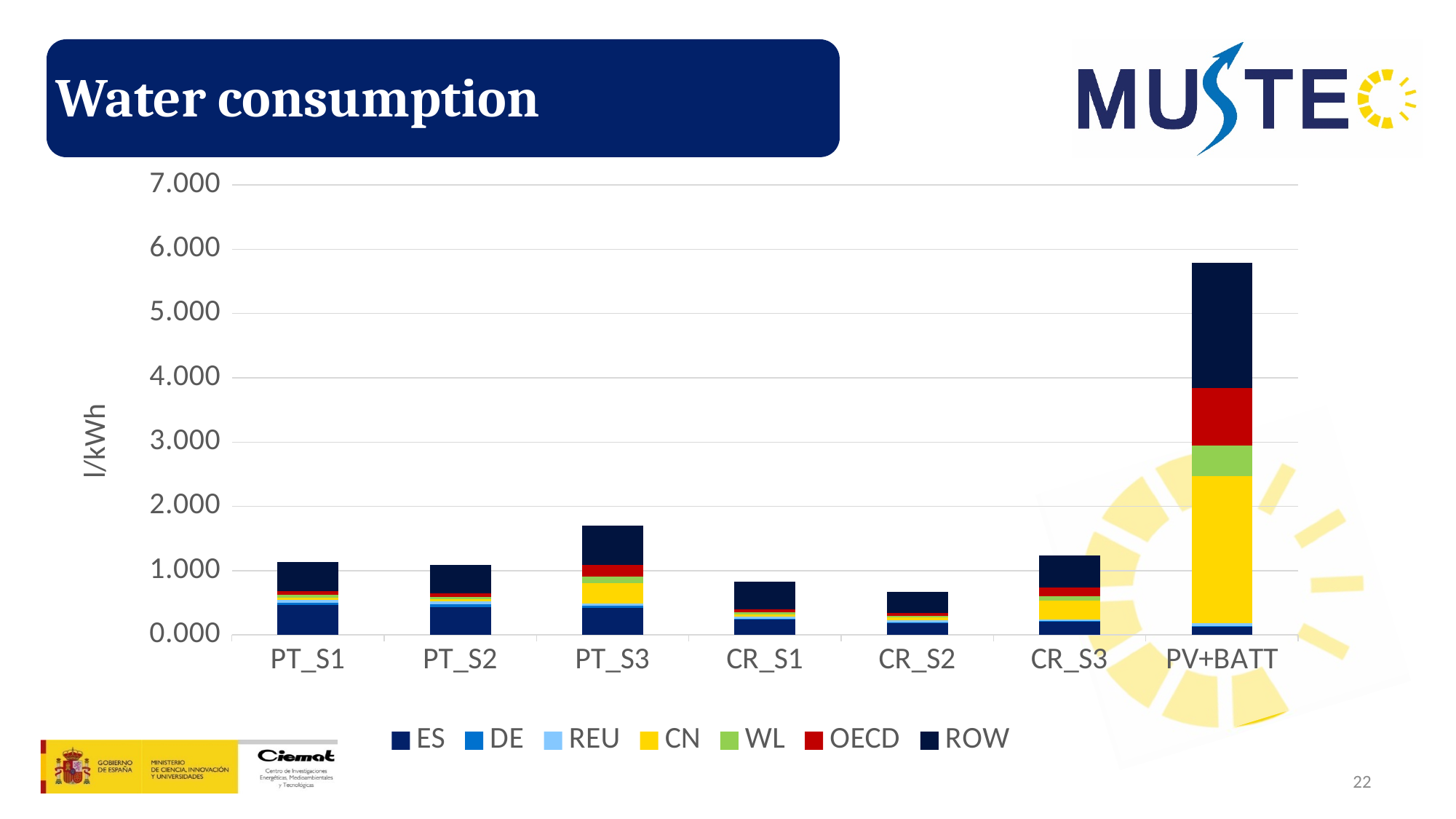
Is the total value for PV+BATT greater or less than 6.000? less What unit is shown on the y axis of the chart? l/kWh What kind of chart is shown on the slide? stacked bar chart Which has the larger total, CR_S1 or CR_S2? CR_S1 How many categories are shown on the x axis of the chart? 7 Is the total value for PV+BATT greater or less than 5.000? greater Which has the larger total, PT_S3 or PT_S1? PT_S3 Which category has the highest total water consumption? PV+BATT How many series does the legend list? 7 Is the total value for PT_S3 greater or less than 1.000? greater Which category has the lowest total water consumption? CR_S2